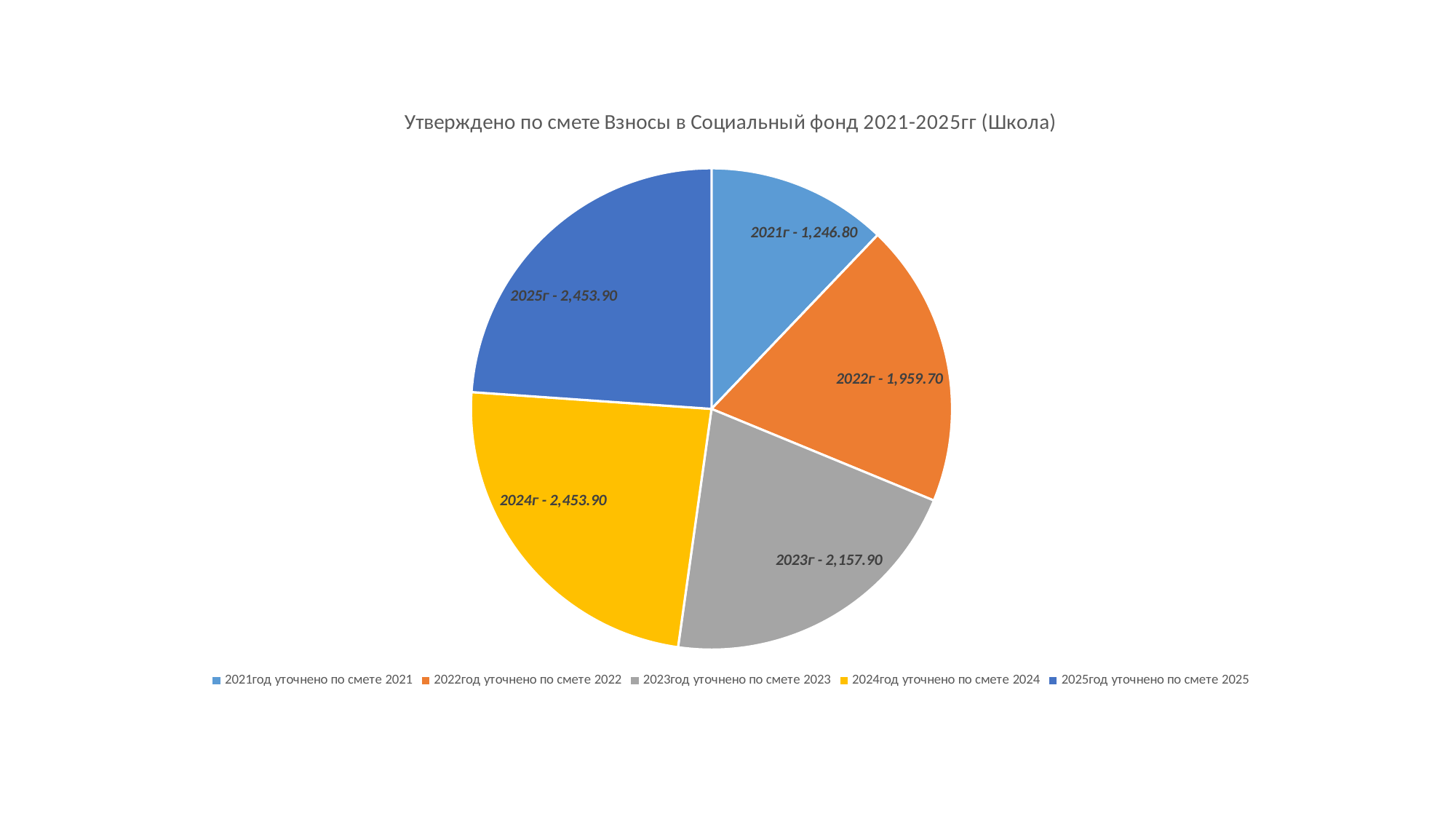
Is the value for 2024г larger than, smaller than, or equal to the value for 2025г? equal What is the value shown for 2021г? 1,246.80 Which year has the smallest slice of the pie? 2021г What is the difference between the values for 2024г and 2023г? 296.00 Which is larger, the value for 2023г or the value for 2022г? 2023г What is the value shown for 2022г? 1,959.70 What is the value shown for 2023г? 2,157.90 What is the title of the chart? Утверждено по смете Взносы в Социальный фонд 2021-2025гг (Школа) What is the value shown for 2025г? 2,453.90 How many slices does the pie chart have? 5 What kind of chart is shown on the slide? pie chart What is the difference between the values for 2022г and 2021г? 712.90